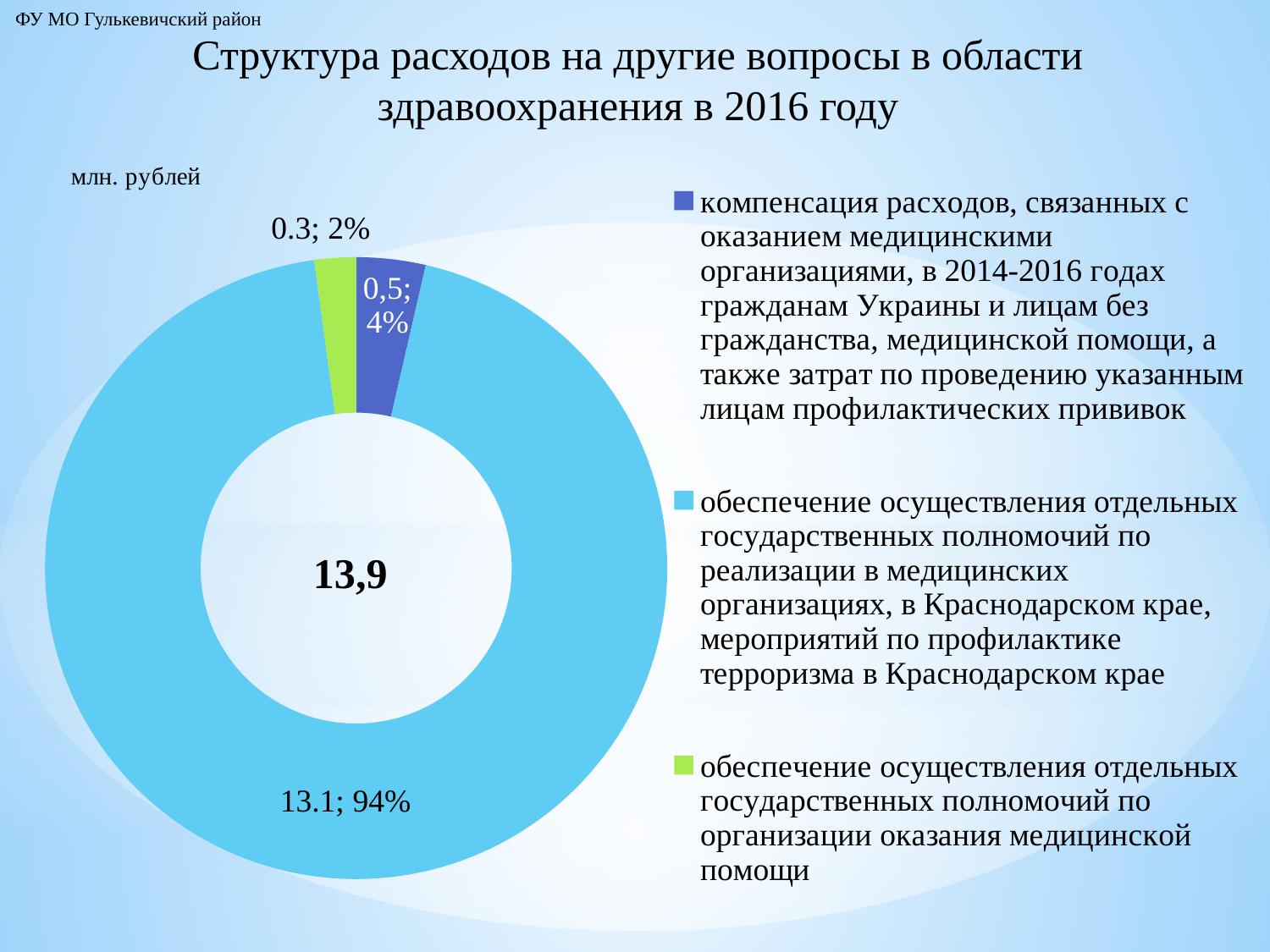
Which slice is the largest? обеспечение осуществления отдельных государственных полномочий по реализации в медицинских организациях, в Краснодарском крае, мероприятий по профилактике терроризма в Краснодарском крае What value is shown for the slice 'компенсация расходов, связанных с оказанием медицинскими организациями, в 2014-2016 годах гражданам Украины и лицам без гражданства, медицинской помощи...'? 0,5 What share of the doughnut does the slice for compensation of expenses for medical care to citizens of Ukraine represent? 4% How many entries does the legend list? 3 What total value is printed in the centre of the doughnut chart? 13,9 What kind of chart is shown on the slide? Doughnut (pie) chart What value is shown for the slice 'обеспечение осуществления отдельных государственных полномочий по реализации в медицинских организациях, в Краснодарском крае, мероприятий по профилактике терроризма в Краснодарском крае'? 13.1 What value is shown for the slice 'обеспечение осуществления отдельных государственных полномочий по организации оказания медицинской помощи'? 0.3 What share of the doughnut does the slice for measures on prevention of terrorism in Krasnodar Krai represent? 94% How many slices does the doughnut chart have? 3 What unit of measurement is indicated for the chart values? млн. рублей Which slice is the smallest? обеспечение осуществления отдельных государственных полномочий по организации оказания медицинской помощи